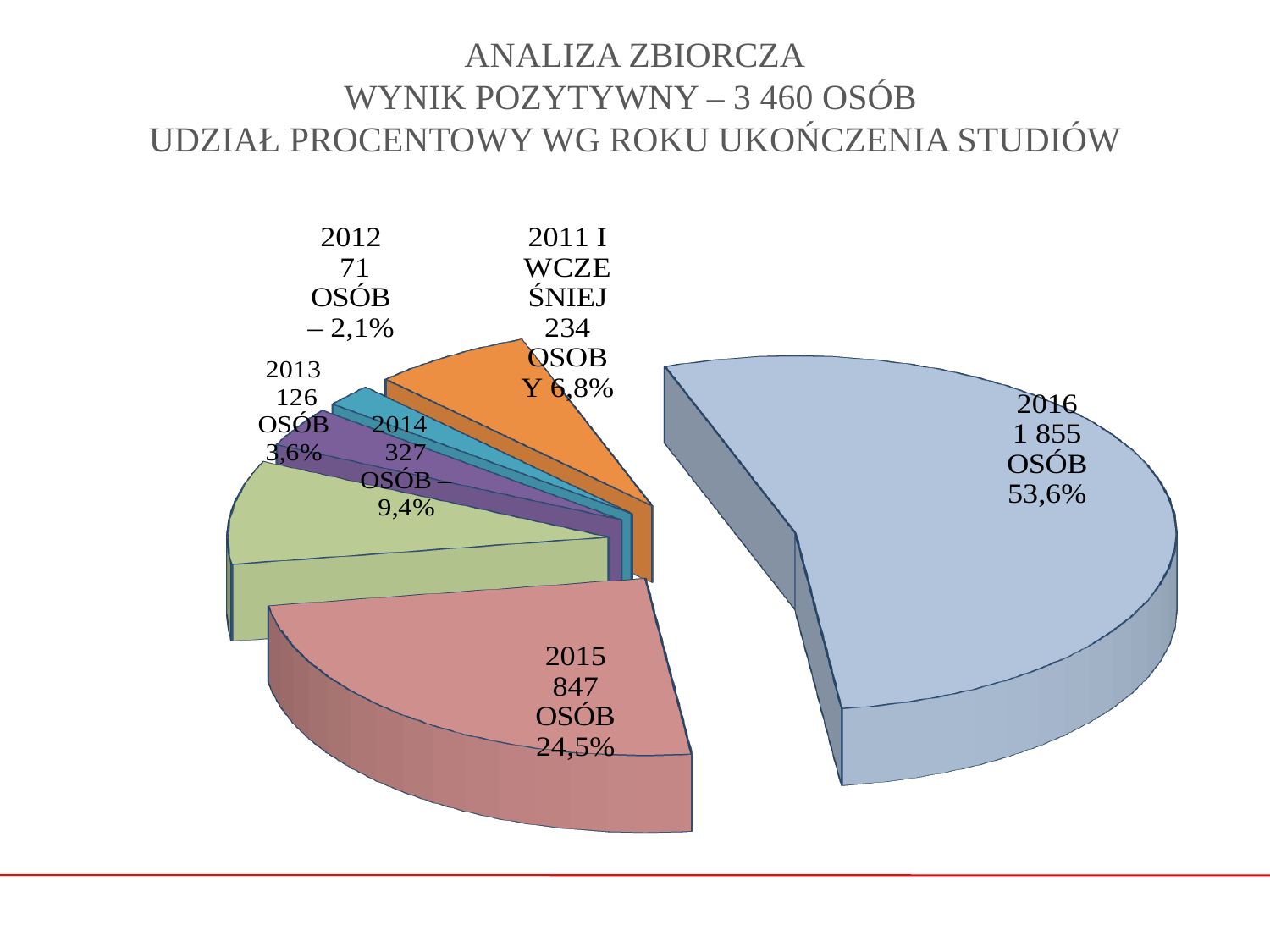
How many people (osób) are shown for 2016? 1 855 Which year has the largest slice of the pie? 2016 Which year has the smallest slice of the pie? 2012 Which is larger, the number of people for 2014 or for 2011 and earlier? 2014 What kind of chart is shown on the slide? pie chart How many slices does the pie chart have? 6 What percentage share does the slice for 2011 and earlier (2011 i wcześniej) have? 6,8% How many people are shown for 2014? 327 What is the difference in number of people between 2016 and 2015? 1 008 How many people are shown for 2012? 71 What percentage share does the 2015 slice have? 24,5% What percentage share does the 2013 slice have? 3,6%